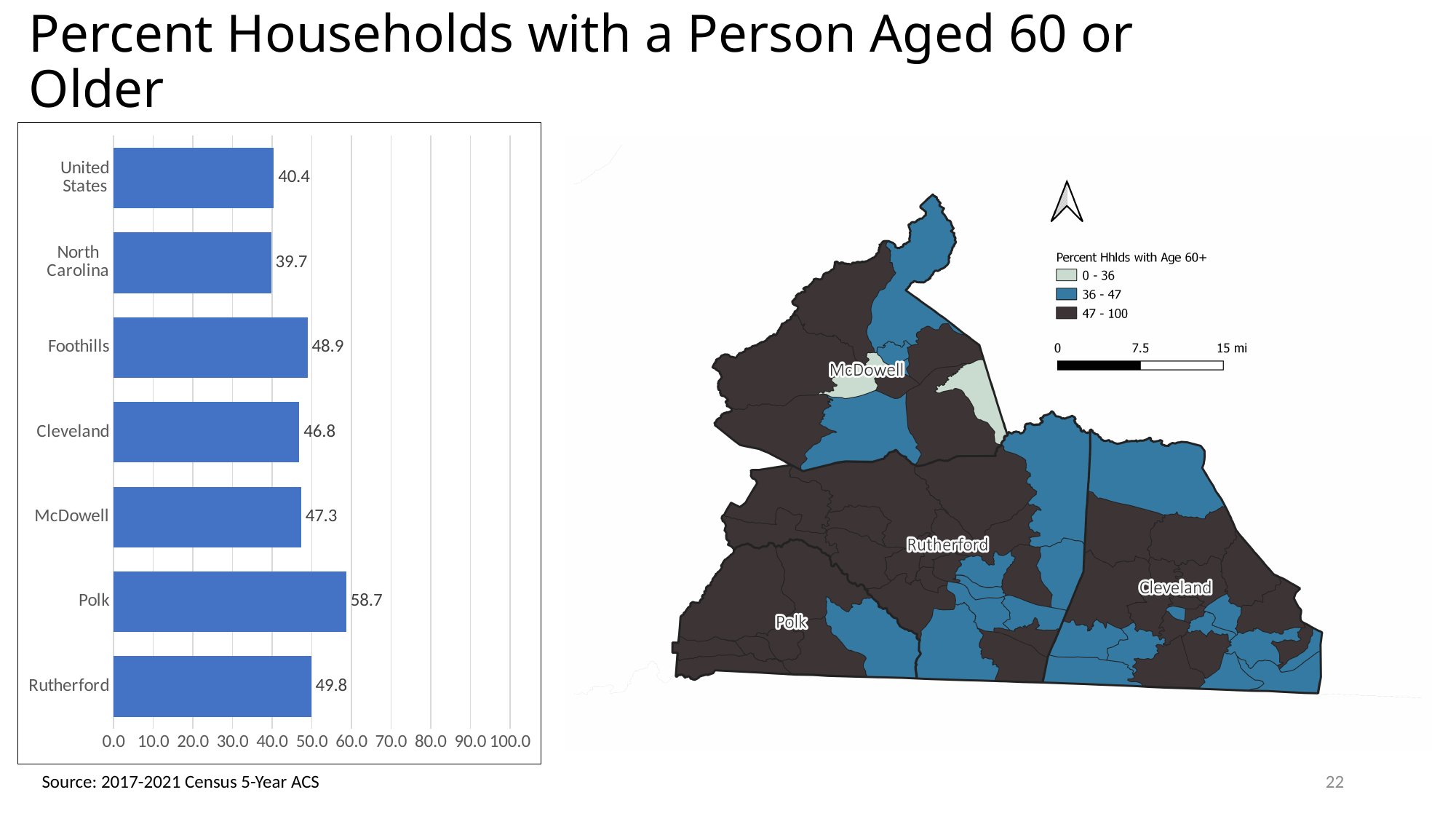
How many categories are shown in the bar chart? 7 Which category has the lowest value in the bar chart? North Carolina What kind of chart is shown on the left of the slide? bar chart Is the value for Rutherford in the bar chart greater or less than 40.0? greater What is the difference between the values for McDowell and Cleveland in the bar chart? 0.5 What is the value for Polk in the bar chart? 58.7 What is the value for Foothills in the bar chart? 48.9 What is the difference between the values for Polk and Rutherford in the bar chart? 8.9 What is the value for the United States in the bar chart? 40.4 Which has a larger value in the bar chart, Foothills or Cleveland? Foothills What is the highest value shown on the x axis of the bar chart? 100.0 Which category has the highest value in the bar chart? Polk